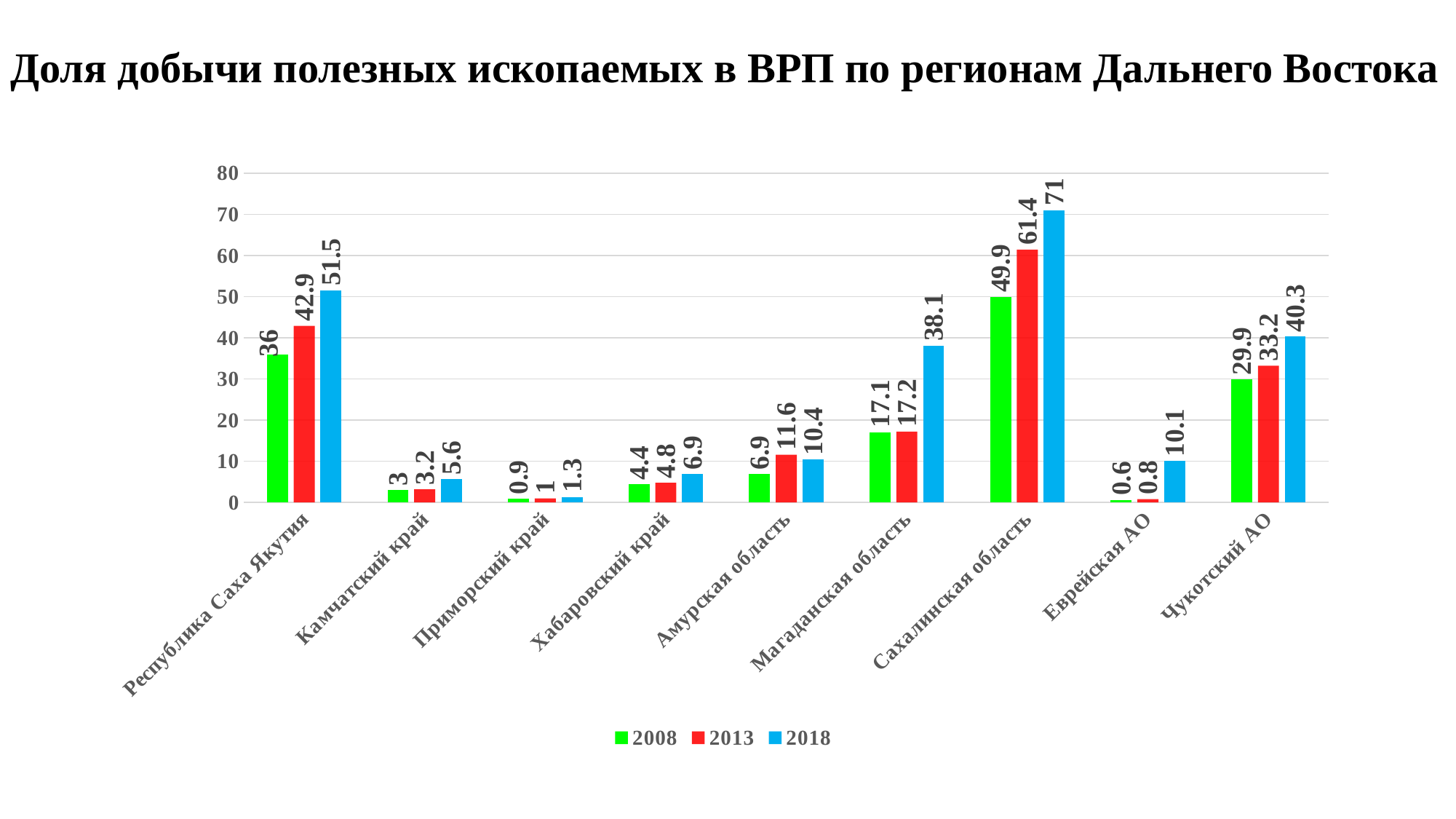
What kind of chart is shown on the slide? Bar chart How many regions are shown on the x axis? 9 Which region has the lowest value in 2008? Еврейская АО How many series does the legend list? 3 What is the value for Республика Саха Якутия in 2008? 36 What is the value for Еврейская АО in 2013? 0.8 Which is larger: the 2018 value for Чукотский АО or the 2018 value for Магаданская область? Чукотский АО Which colour represents the 2013 series in the legend? Red What is the difference between the 2018 and 2008 values for Магаданская область? 21 Which region has the highest value in 2018? Сахалинская область Do the values for Амурская область rise or fall from 2013 to 2018? Fall What is the value for Сахалинская область in 2018? 71